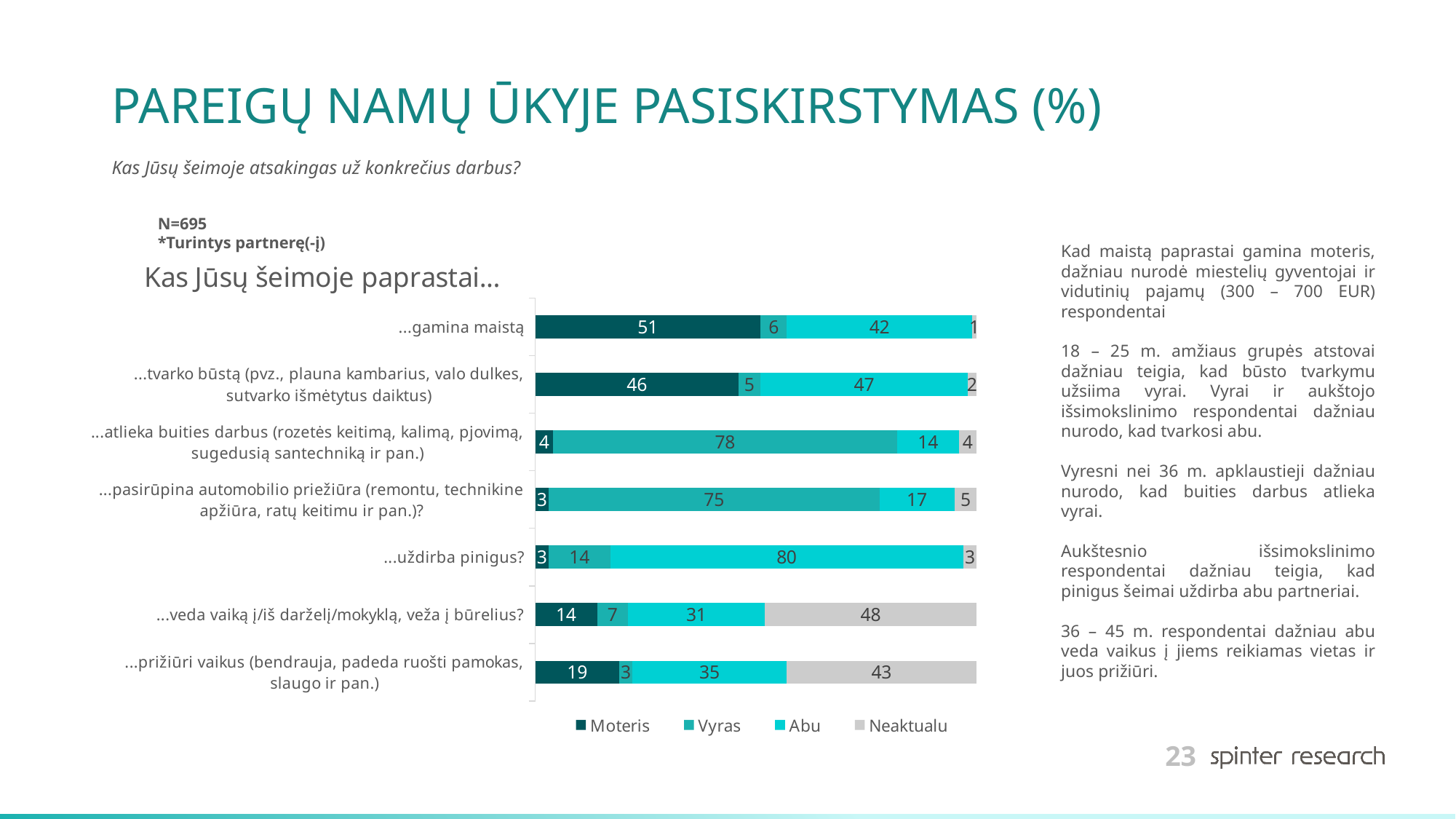
Which category has the lowest Moteris value? ...pasirūpina automobilio priežiūra and ...uždirba pinigus? (both 3) What is the difference between the Abu value and the Moteris value for '...tvarko būstą'? 1 What is the Abu value for '...uždirba pinigus?'? 80 Which category has the highest Vyras value? ...atlieka buities darbus (rozetės keitimą, kalimą, pjovimą, sugedusią santechniką ir pan.) What is the Neaktualu value for '...veda vaiką į/iš darželį/mokyklą, veža į būrelius?'? 48 What is the sample size (N) stated on the slide? N=695 What percentage of respondents say the woman (Moteris) usually cooks food (...gamina maistą)? 51 What kind of chart is shown on the slide? Stacked bar chart For '...prižiūri vaikus', which is larger: the Abu value or the Neaktualu value? Neaktualu How many series does the legend list? 4 What is the Vyras value for '...atlieka buities darbus'? 78 How many categories (household tasks) are shown in the chart? 7